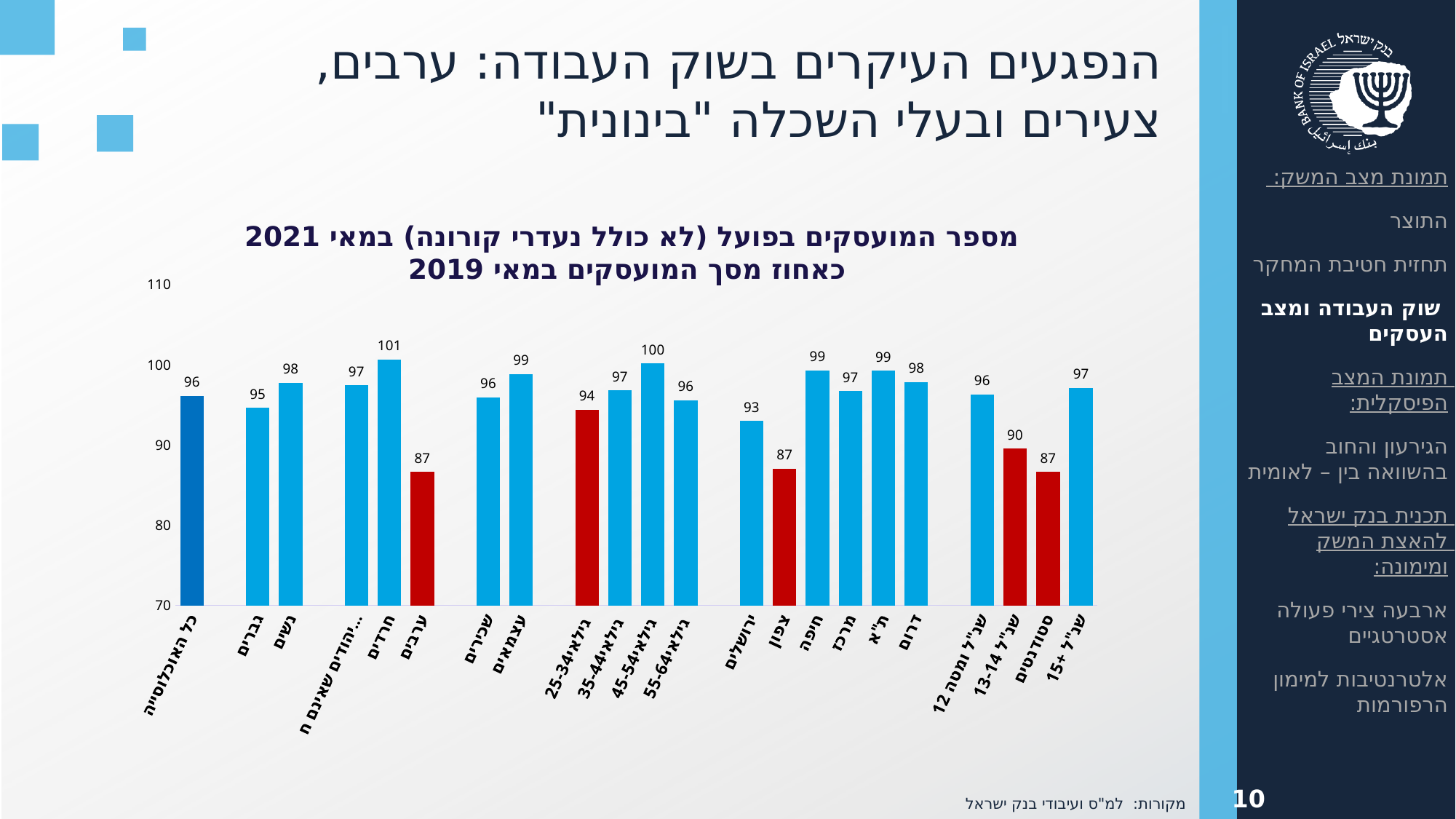
What is the value for חרדים? 101 How many bars are shown in the chart? 22 What is the value for גילאי 45-54? 100 Which category has the highest value? חרדים What type of chart is shown on the slide? bar chart What is the difference between the values for נשים and גברים? 3 What is the lowest value shown in the chart? 87 What is the value for ערבים? 87 What is the value for כל האוכלוסייה, the first bar in the chart? 96 Which is larger, the value for ירושלים or the value for חיפה? חיפה What is the value for סטודנטים? 87 Is the value for שנ"ל 13-14 greater or less than 100? less